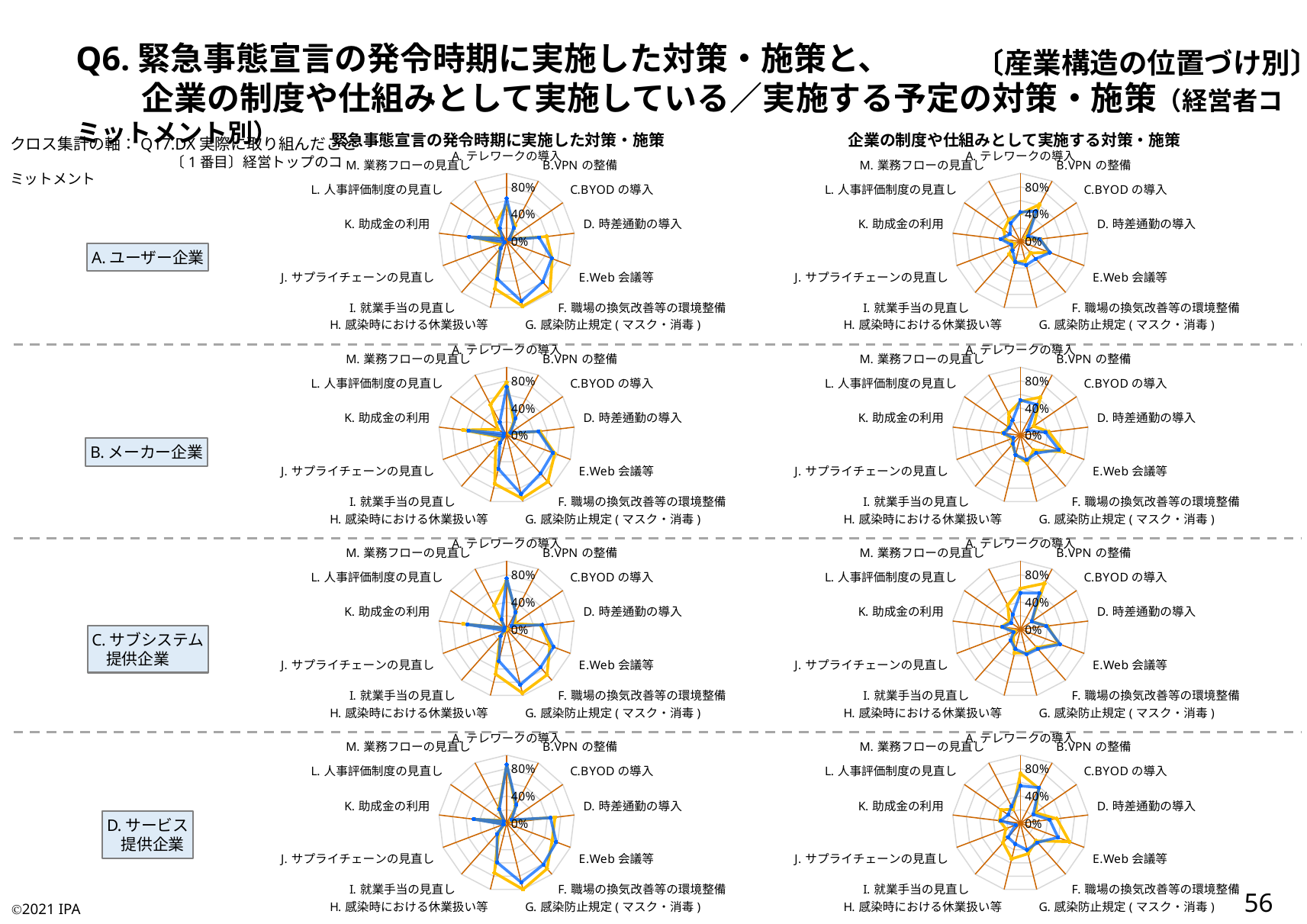
In the A. ユーザー企業 chart under 企業の制度や仕組みとして実施する対策・施策, is the value for C.BYODの導入 greater or less than 40%? less What is the title of the right column of radar charts? 企業の制度や仕組みとして実施する対策・施策 What kind of chart is used for A. ユーザー企業 under 緊急事態宣言の発令時期に実施した対策・施策? radar chart In the D. サービス提供企業 chart under 企業の制度や仕組みとして実施する対策・施策, is the value for J. サプライチェーンの見直し greater or less than 40%? less How many radar charts are shown on the slide? 8 In the B. メーカー企業 chart under 緊急事態宣言の発令時期に実施した対策・施策, is the value for G. 感染防止規定(マスク・消毒) greater or less than 40%? greater How many categories (axes) does the radar chart for B. メーカー企業 under 緊急事態宣言の発令時期に実施した対策・施策 have? 13 What is the title of the left column of radar charts? 緊急事態宣言の発令時期に実施した対策・施策